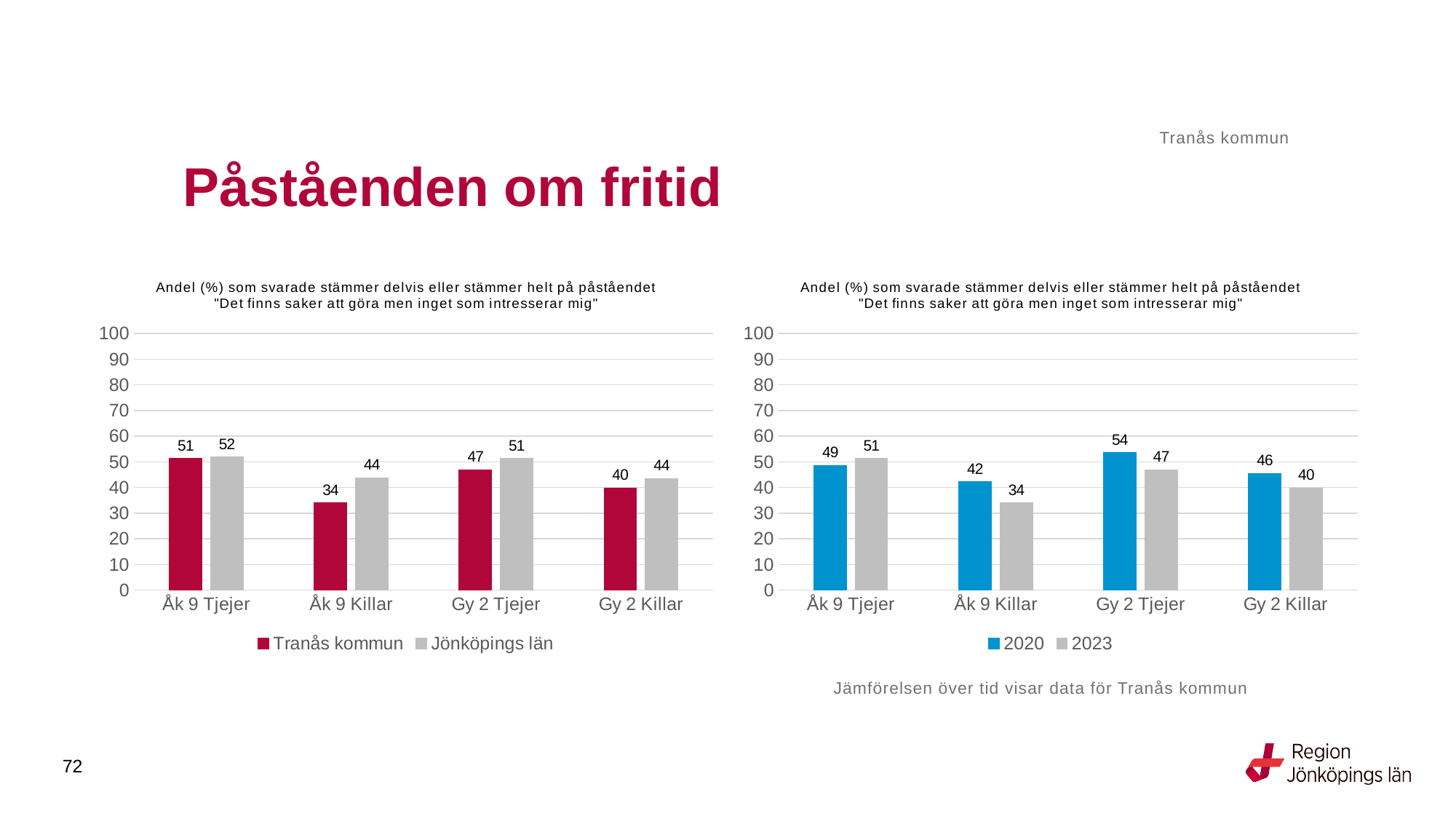
In the left chart, what is the difference between Jönköpings län and Tranås kommun for Åk 9 Killar? 10 In the left chart, which category has the lowest value for Tranås kommun? Åk 9 Killar What kind of chart is the left chart? Bar chart In the left chart, what is the value for Tranås kommun for Åk 9 Killar? 34 In the right chart, what is the value for 2023 for Gy 2 Killar? 40 How many categories are shown on the x axis of the right chart? 4 In the right chart, what is the value for 2020 for Gy 2 Tjejer? 54 In the left chart, how many series does the legend list? 2 In the left chart, what is the value for Jönköpings län for Gy 2 Tjejer? 51 In the right chart, what is the difference between 2020 and 2023 for Gy 2 Tjejer? 7 In the right chart, which is larger for Åk 9 Killar, 2020 or 2023? 2020 In the right chart, which category has the highest value for 2020? Gy 2 Tjejer